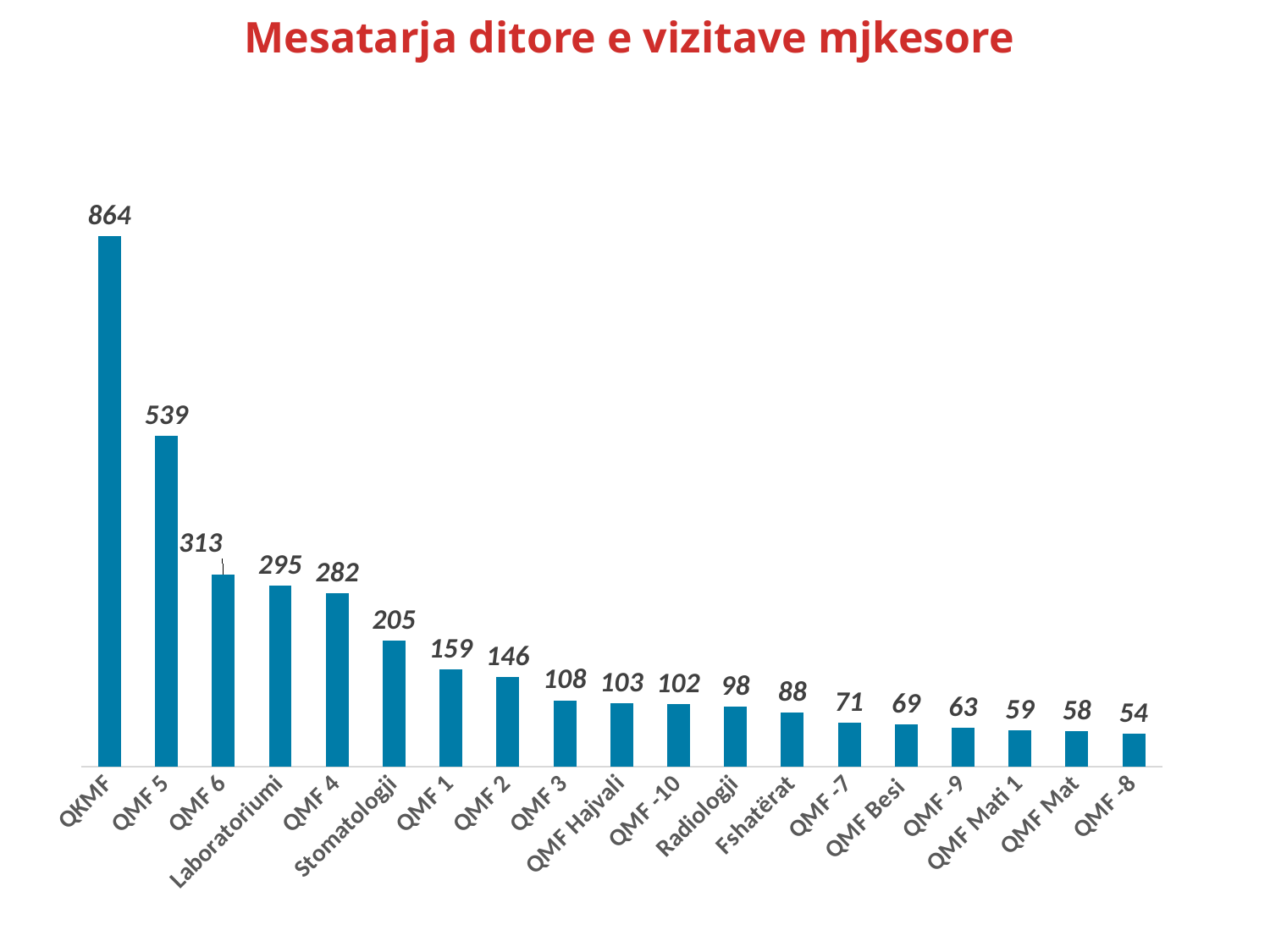
Which category has the lowest value? QMF -8 What is the value for QKMF? 864 How many categories are shown in the chart? 19 What is the title of the chart? Mesatarja ditore e vizitave mjkesore What is the value for Stomatologji? 205 What is the difference between the values for QKMF and QMF 5? 325 What is the value for QMF Hajvali? 103 Which category has the highest value? QKMF What kind of chart is shown on the slide? Bar chart What is the value for Fshatërat? 88 Which is larger, the value for QMF 6 or the value for Stomatologji? QMF 6 What is the difference between the values for Laboratoriumi and QMF 4? 13